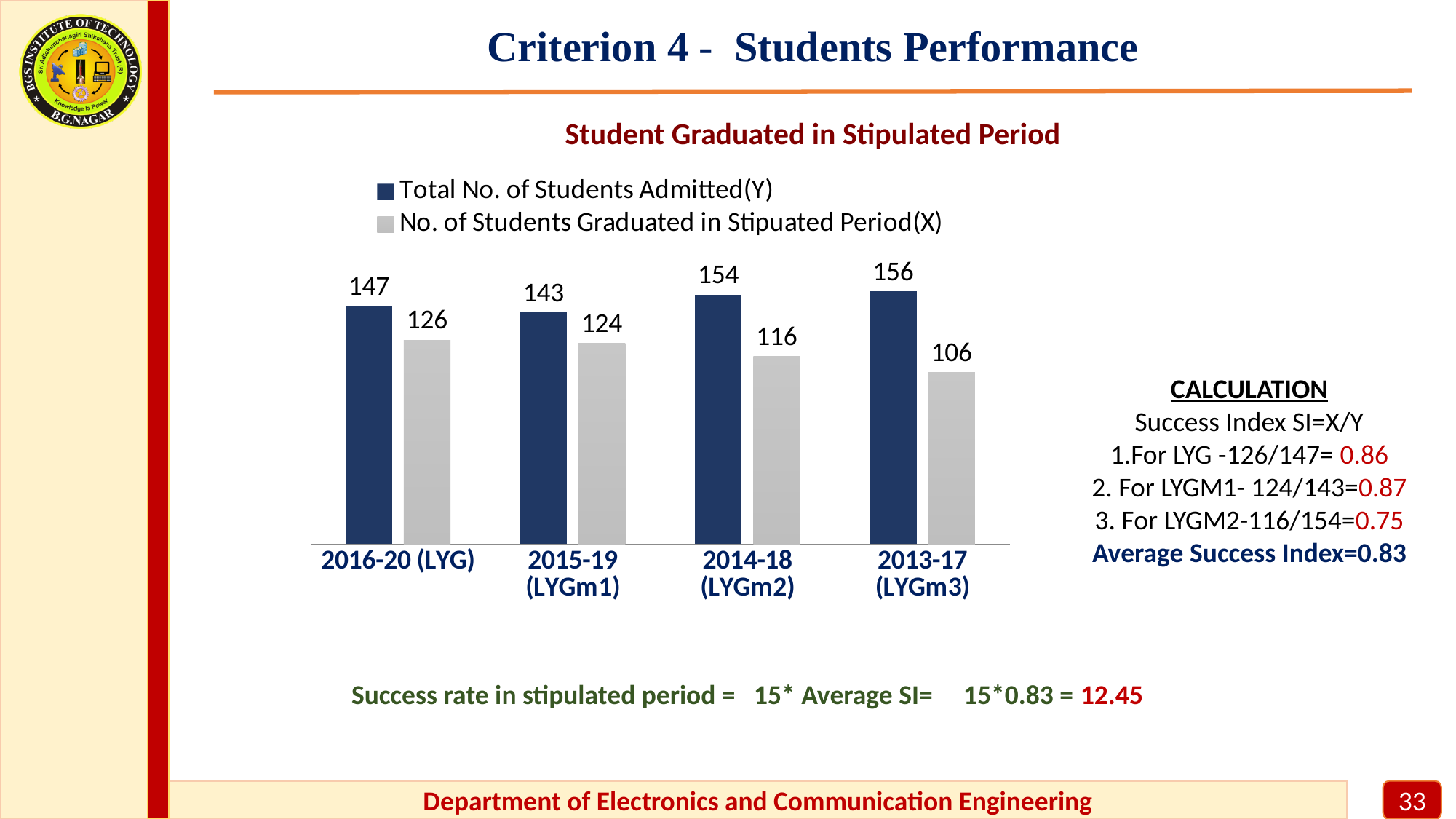
Which category has the highest Total No. of Students Admitted(Y)? 2013-17 (LYGm3) What is the Total No. of Students Admitted(Y) for 2016-20 (LYG)? 147 How many categories are shown on the x axis of the chart? 4 Does the No. of Students Graduated in Stipuated Period(X) rise or fall from 2016-20 (LYG) to 2013-17 (LYGm3) along the x axis? Fall Which is larger: the No. of Students Graduated in Stipuated Period(X) for 2016-20 (LYG) or for 2014-18 (LYGm2)? 2016-20 (LYG) What is the difference between the Total No. of Students Admitted(Y) and the No. of Students Graduated in Stipuated Period(X) for 2015-19 (LYGm1)? 19 What is the No. of Students Graduated in Stipuated Period(X) for 2013-17 (LYGm3)? 106 Which category has the lowest No. of Students Graduated in Stipuated Period(X)? 2013-17 (LYGm3) What is the No. of Students Graduated in Stipuated Period(X) for 2014-18 (LYGm2)? 116 How many series does the chart legend list? 2 What is the title of the chart? Student Graduated in Stipulated Period What kind of chart is shown on the slide? Bar chart